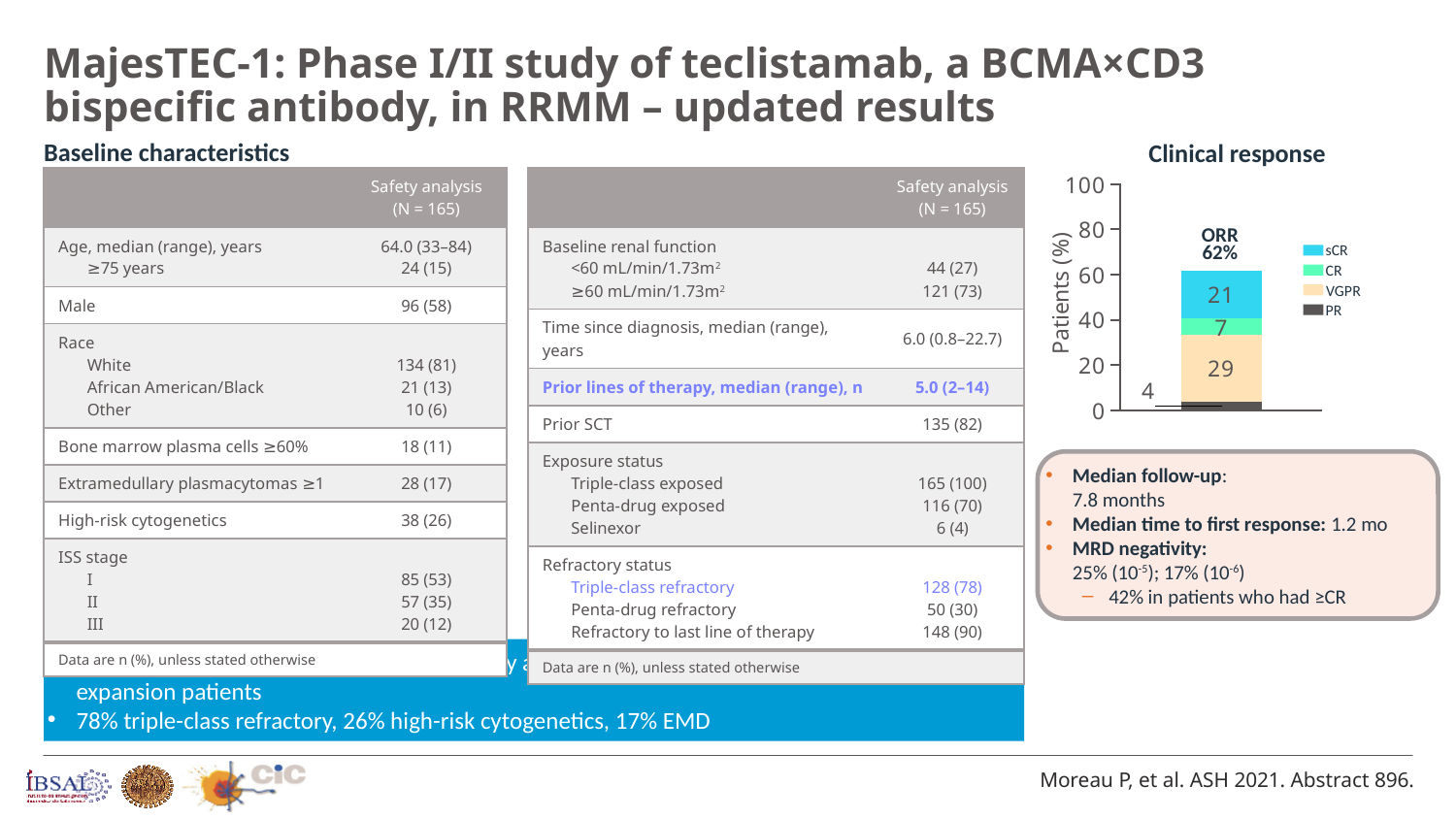
In the Clinical response chart, what is the value for VGPR? 29 In the Clinical response chart, what is the value for PR? 4 In the Clinical response chart, what is the value for sCR? 21 What ORR value is printed above the bar in the Clinical response chart? 62% In the Clinical response chart, which response category has the smallest segment? PR In the Clinical response chart, which is larger, the sCR segment or the CR segment? sCR What kind of chart is the Clinical response chart? Stacked bar chart What is the y-axis title of the Clinical response chart? Patients (%) How many series does the legend of the Clinical response chart list? 4 In the Clinical response chart, what is the value for CR? 7 In the Clinical response chart, which response category has the largest segment? VGPR In the Clinical response chart, what is the difference between the VGPR value and the sCR value? 8